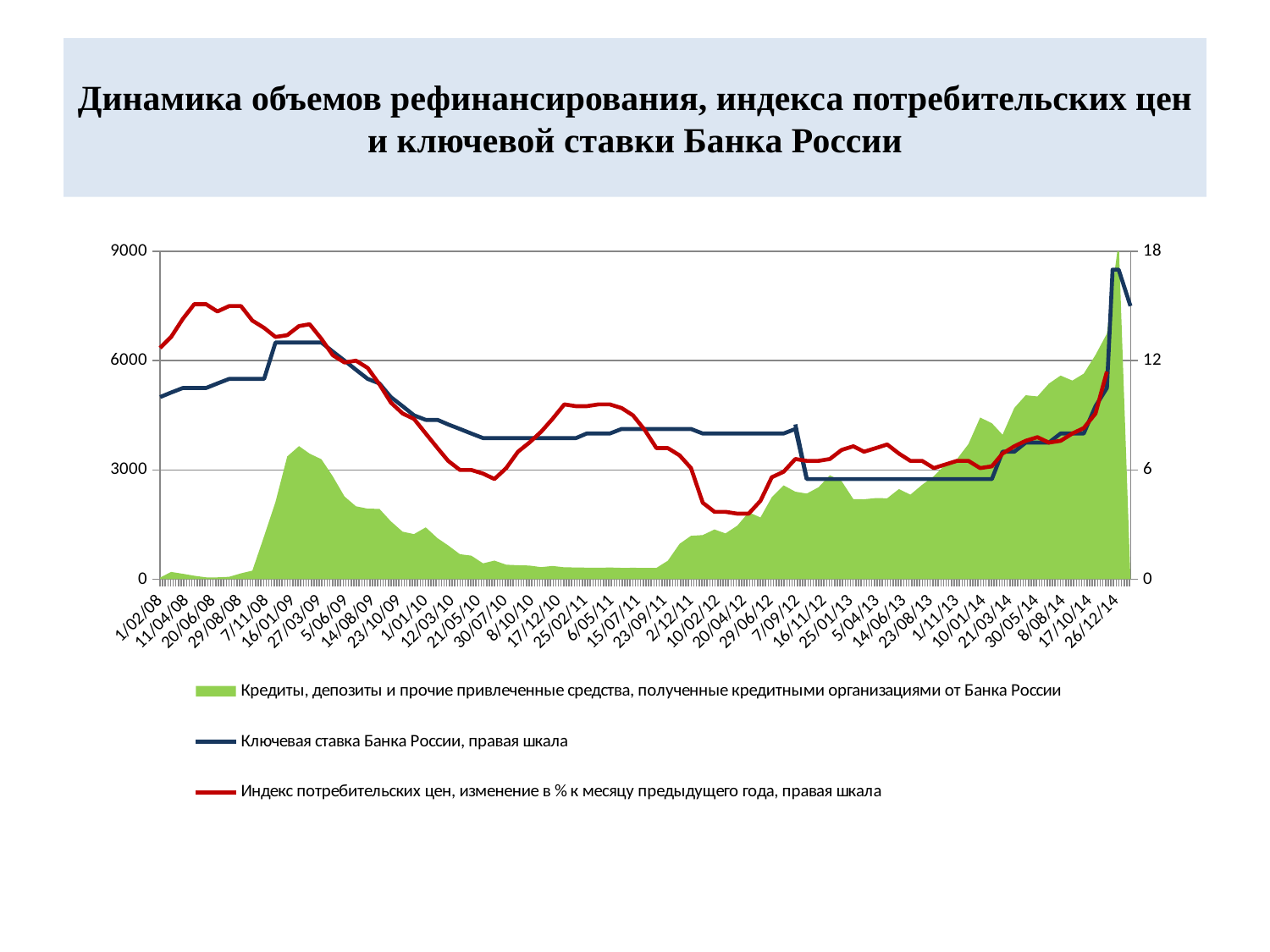
Is the Ключевая ставка Банка России at 16/01/09 greater or less than 12 on the right scale? greater At 21/05/10, which is higher: the Ключевая ставка Банка России or the Индекс потребительских цен? Ключевая ставка Банка России Does the Ключевая ставка Банка России rise or fall between 16/01/09 and 30/07/10? fall Is the Ключевая ставка Банка России at 25/01/13 greater or less than 6 on the right scale? less Is the Индекс потребительских цен at 10/02/12 greater or less than 6 on the right scale? less Which series is plotted as a green filled area? Кредиты, депозиты и прочие привлеченные средства, полученные кредитными организациями от Банка России How many series does the legend list? 3 At 1/02/08, which is higher: the Индекс потребительских цен or the Ключевая ставка Банка России? Индекс потребительских цен What kind of chart is shown on the slide? A combination of an area chart and line charts What is the maximum value shown on the right-hand axis? 18